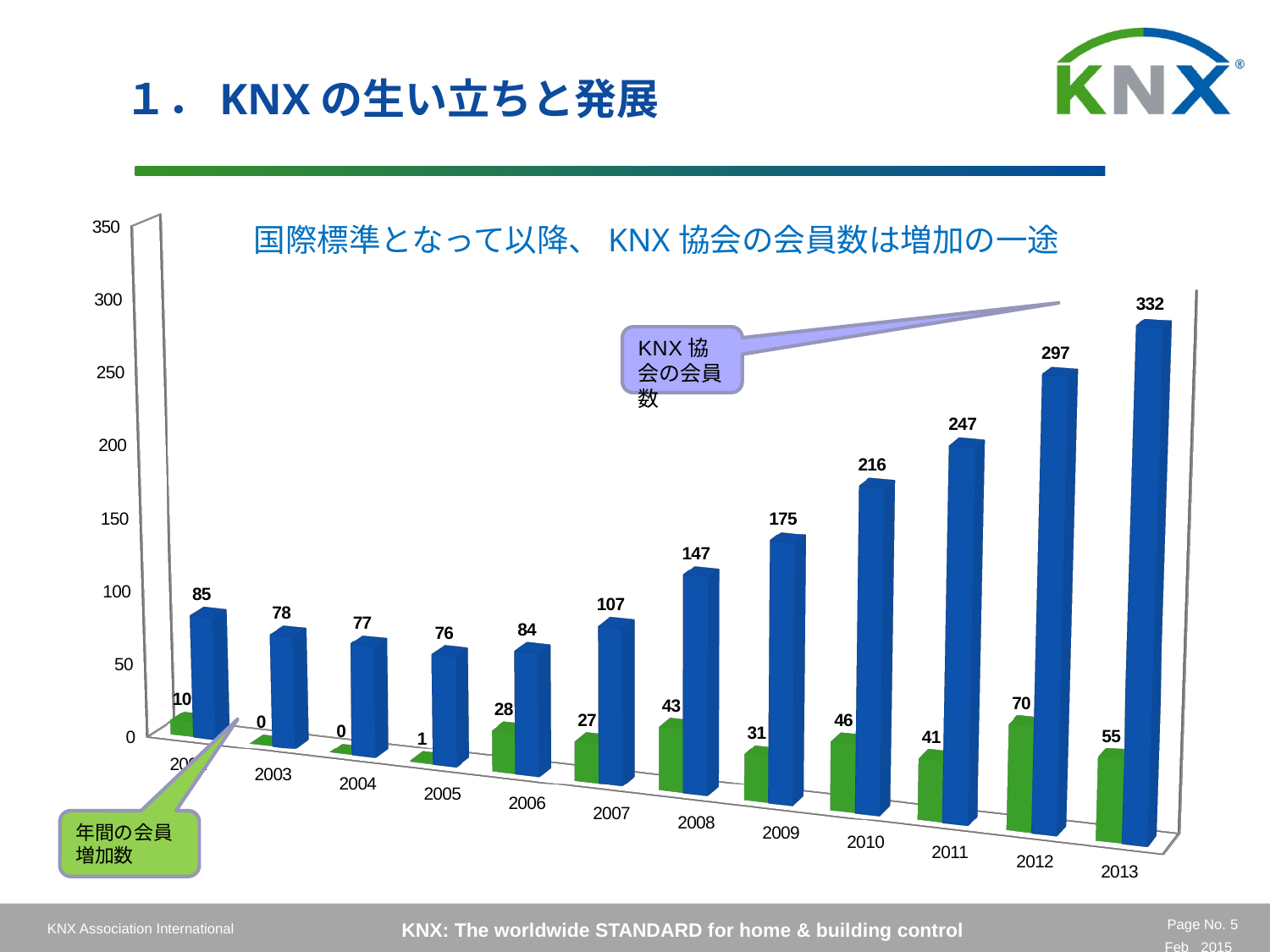
What is the annual member increase (green bar) in 2012? 70 How many series does the chart show? 2 What is the number of KNX association members (blue bar) in 2008? 147 What is the number of KNX association members (blue bar) in 2013? 332 Which is larger: the number of KNX association members in 2010 or in 2011? 2011 Is the number of KNX association members (blue bar) in 2011 greater or less than 200? greater Which year has the highest number of KNX association members (blue bar)? 2013 What is the difference in KNX association members (blue bar) between 2013 and 2012? 35 What colour are the bars representing the annual member increase (年間の会員増加数)? Green Do the blue bars (KNX association members) rise or fall from 2005 to 2013? Rise What kind of chart is shown on the slide? Bar chart Which year has the highest annual member increase (green bar)? 2012